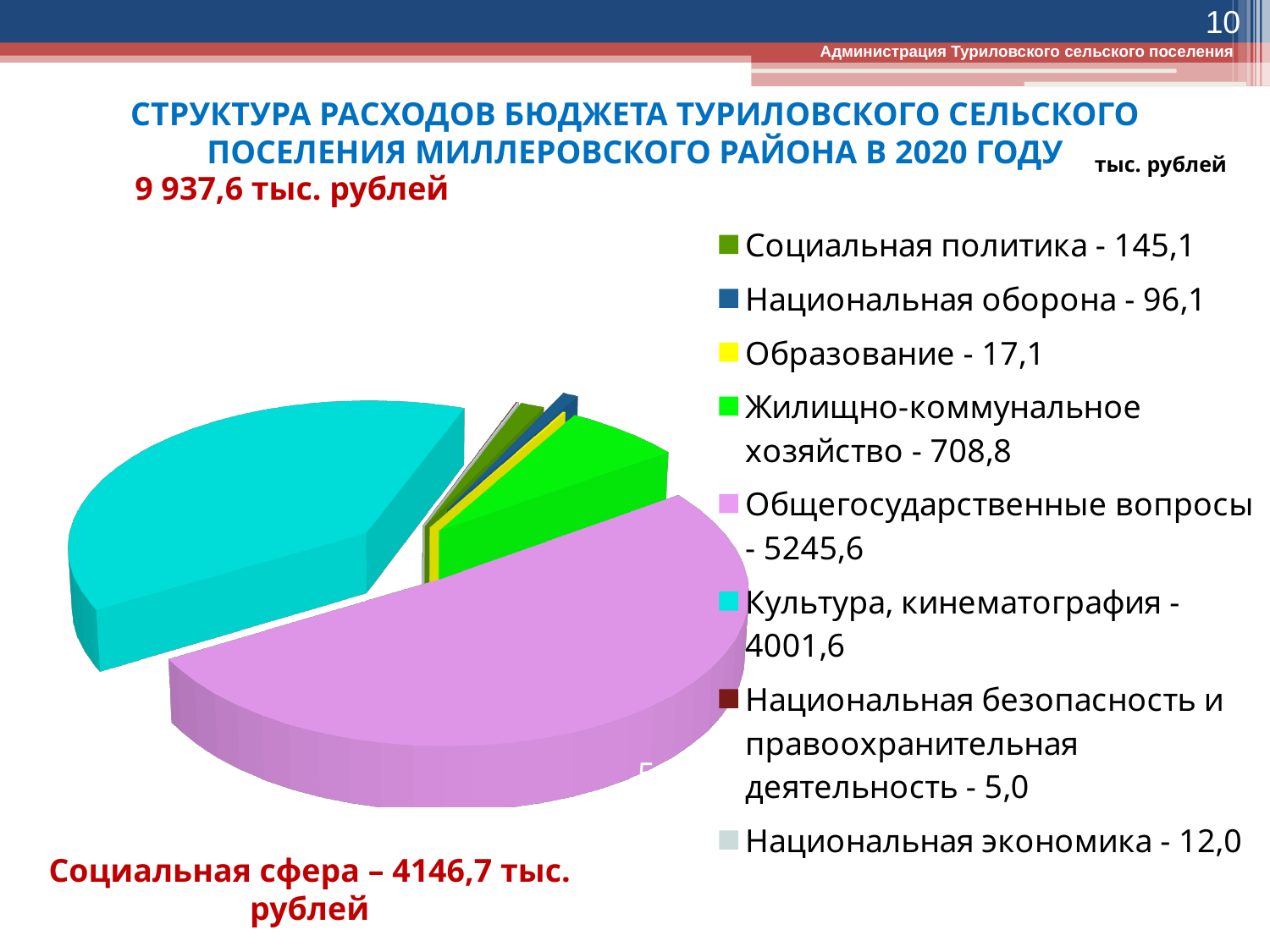
What is the value for Общегосударственные вопросы? 5245,6 Which category has the largest value in the pie chart? Общегосударственные вопросы What is the difference between the values for Общегосударственные вопросы and Культура, кинематография? 1244,0 What is the value for Жилищно-коммунальное хозяйство? 708,8 What is the value for Культура, кинематография? 4001,6 What is the difference between the values for Жилищно-коммунальное хозяйство and Социальная политика? 563,7 How many categories does the legend of the pie chart list? 8 What kind of chart is shown on the slide? Pie chart Which is larger: the value for Социальная политика or the value for Национальная оборона? Социальная политика What colour is the slice for Культура, кинематография in the pie chart? Cyan (turquoise) What is the value for Национальная оборона? 96,1 Which category has the smallest value in the pie chart? Национальная безопасность и правоохранительная деятельность